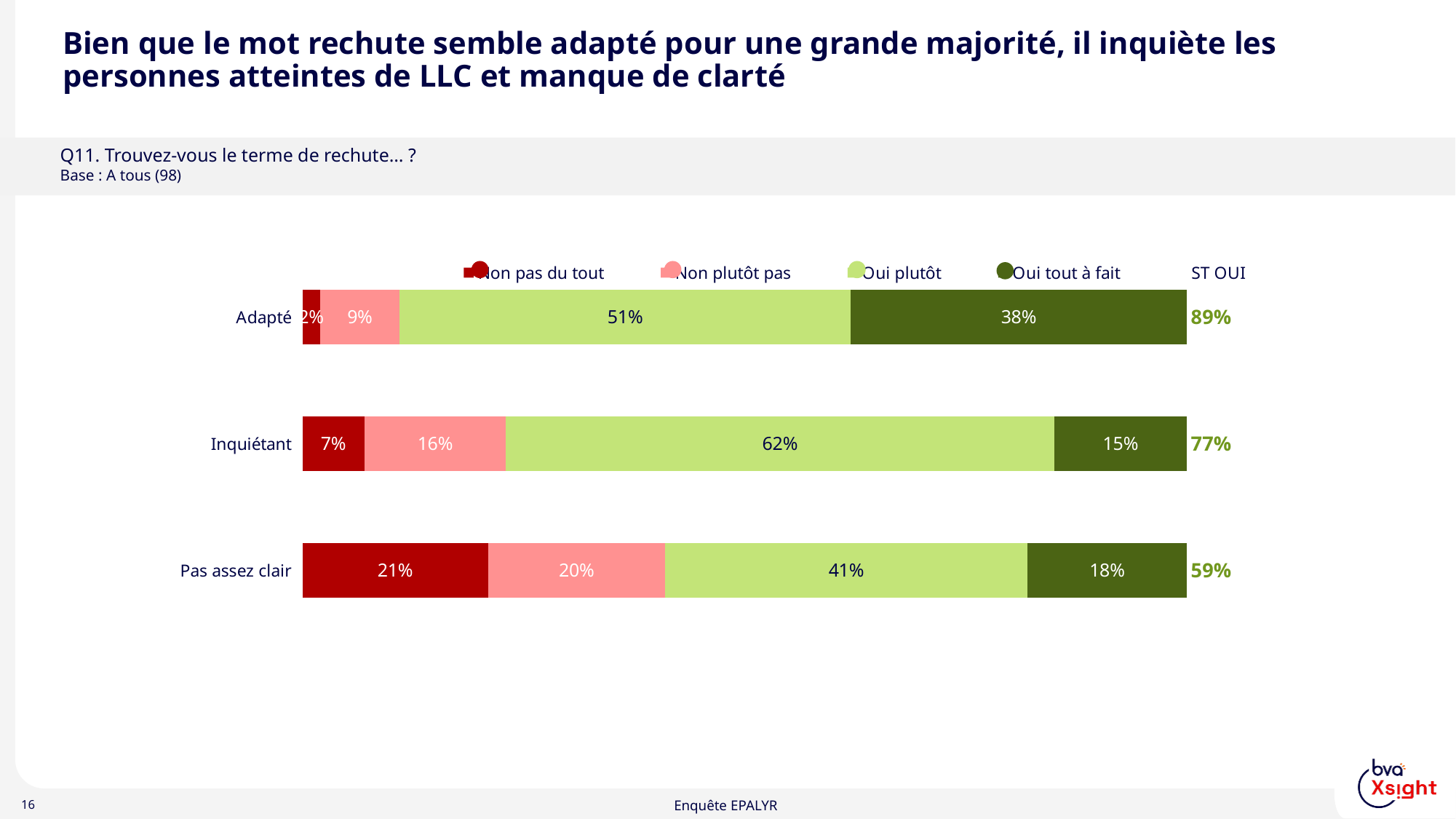
What is the value of "Non pas du tout" for Pas assez clair? 21% Which is larger: the "Non plutôt pas" value for Inquiétant or for Pas assez clair? Pas assez clair What kind of chart is shown on the slide? Stacked bar chart Which category has the highest "Oui tout à fait" value? Adapté What is the total of the "Oui plutôt" and "Oui tout à fait" segments for Pas assez clair? 59% How many series does the legend list? 4 What is the ST OUI value for Inquiétant? 77% What is the difference between the "Oui plutôt" values for Inquiétant and Pas assez clair? 21% How many categories are shown in the chart? 3 What is the value of "Oui tout à fait" for Inquiétant? 15% Which category has the lowest "Non pas du tout" value? Adapté What is the value of "Oui plutôt" for Adapté? 51%